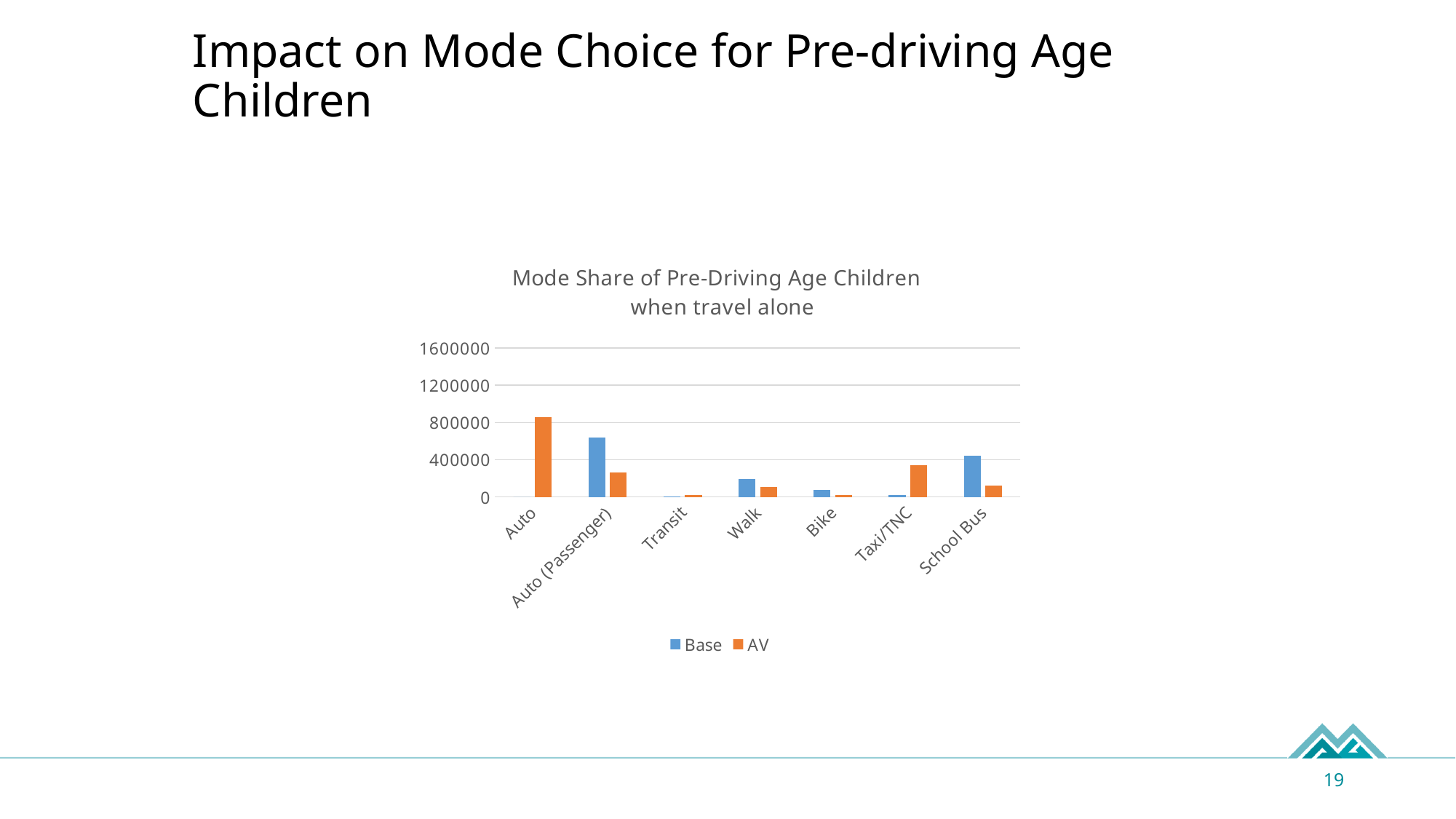
For School Bus, which series has the larger value, Base or AV? Base What colour represents the AV series in the chart? Orange For Taxi/TNC, which series has the larger value, Base or AV? AV Which category has the highest AV value? Auto Is the AV value for Auto greater or less than 400000? greater Is the AV value for School Bus greater or less than 400000? less Which category has the highest Base value? Auto (Passenger) How many mode categories are shown on the x axis? 7 Is the Base value for Auto (Passenger) greater or less than 400000? greater What kind of chart is shown on the slide? Bar chart How many series does the legend list? 2 What is the title of the chart? Mode Share of Pre-Driving Age Children when travel alone